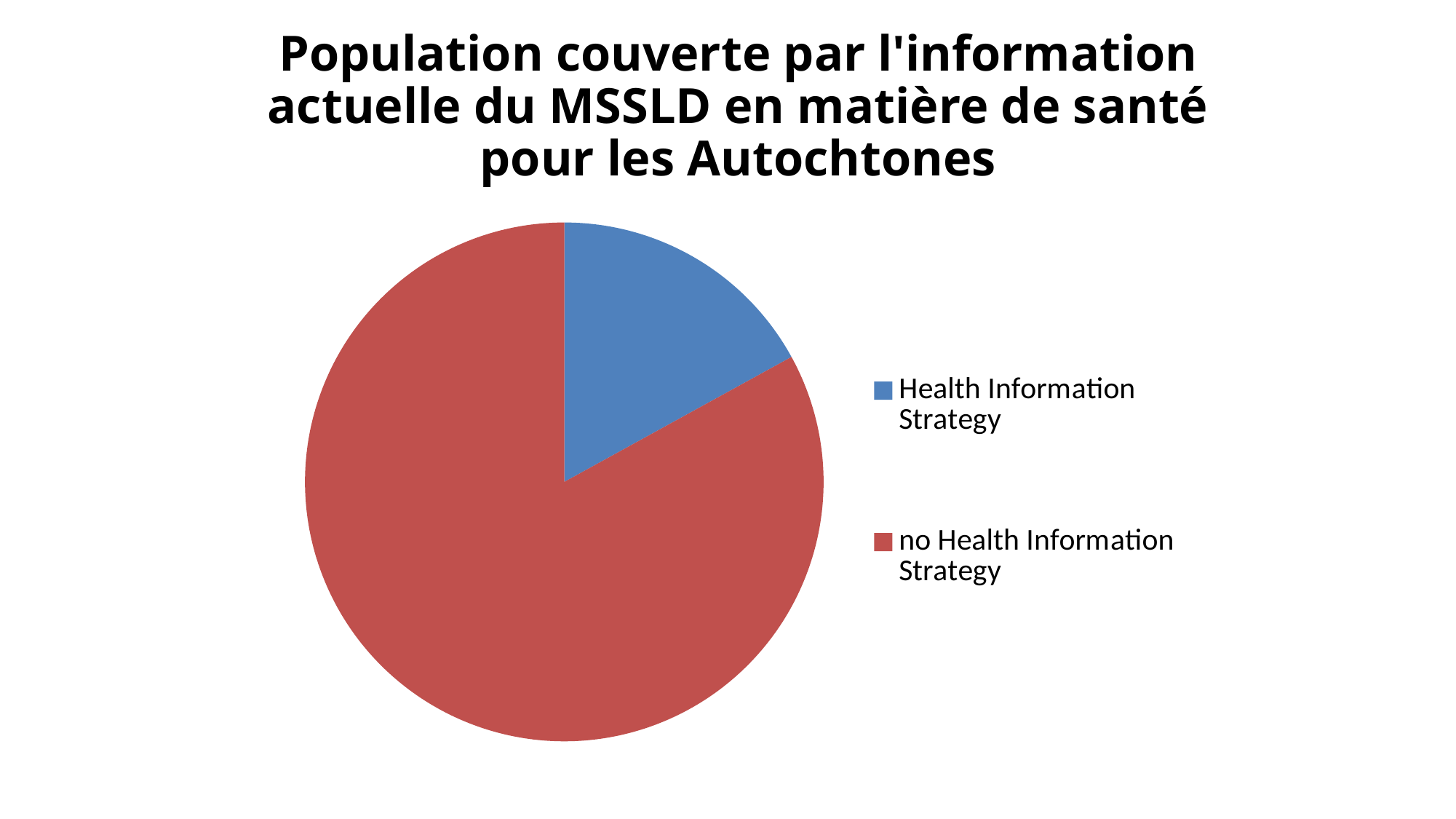
What kind of chart is shown on the slide? pie chart Which slice is larger: Health Information Strategy or no Health Information Strategy? no Health Information Strategy Which category has the smallest slice of the pie? Health Information Strategy What colour is the slice for Health Information Strategy? blue How many entries does the legend list? 2 Which category has the largest slice of the pie? no Health Information Strategy What is the title of the chart? Population couverte par l'information actuelle du MSSLD en matière de santé pour les Autochtones How many slices does the pie chart have? 2